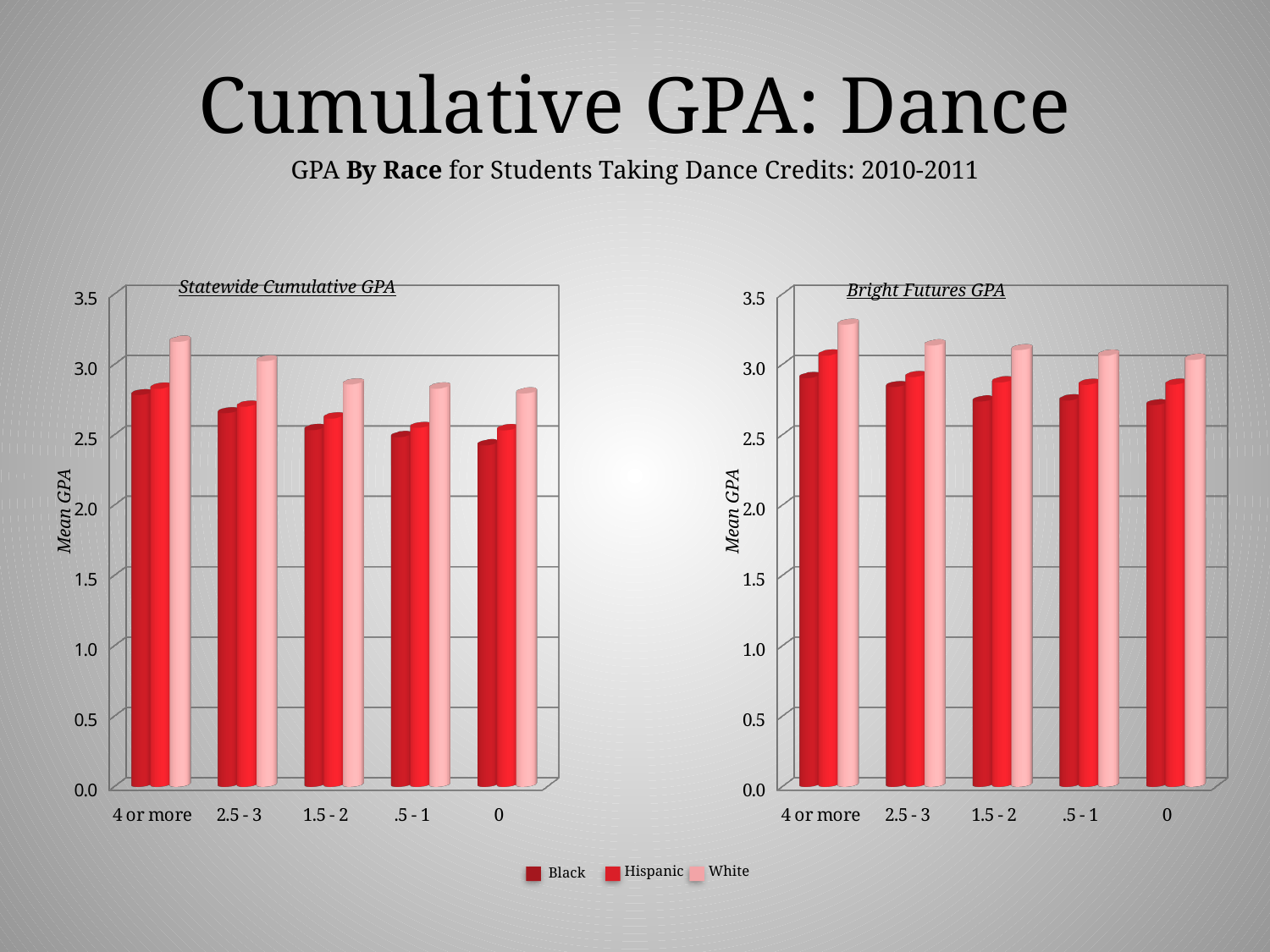
In the Statewide Cumulative GPA chart, which series has the highest value in the '2.5 - 3' category? White In the Statewide Cumulative GPA chart, is the value for White students in the '4 or more' category greater or less than 3.0? greater How many series does the legend list? 3 How many categories are shown on the x axis of the Bright Futures GPA chart? 5 In the Statewide Cumulative GPA chart, do the values for Black students rise or fall from '4 or more' to '0' along the x axis? fall In the Bright Futures GPA chart, is the value for Black students in the '1.5 - 2' category greater or less than 2.5? greater In the Statewide Cumulative GPA chart, is the value for Black students in the '0' category greater or less than 2.5? less In the Statewide Cumulative GPA chart, which is larger for the '4 or more' category: the Black value or the White value? White What kind of chart is the Statewide Cumulative GPA chart? bar chart In the Bright Futures GPA chart, which series has the lowest value in the '0' category? Black What is the label on the y axis of the Bright Futures GPA chart? Mean GPA